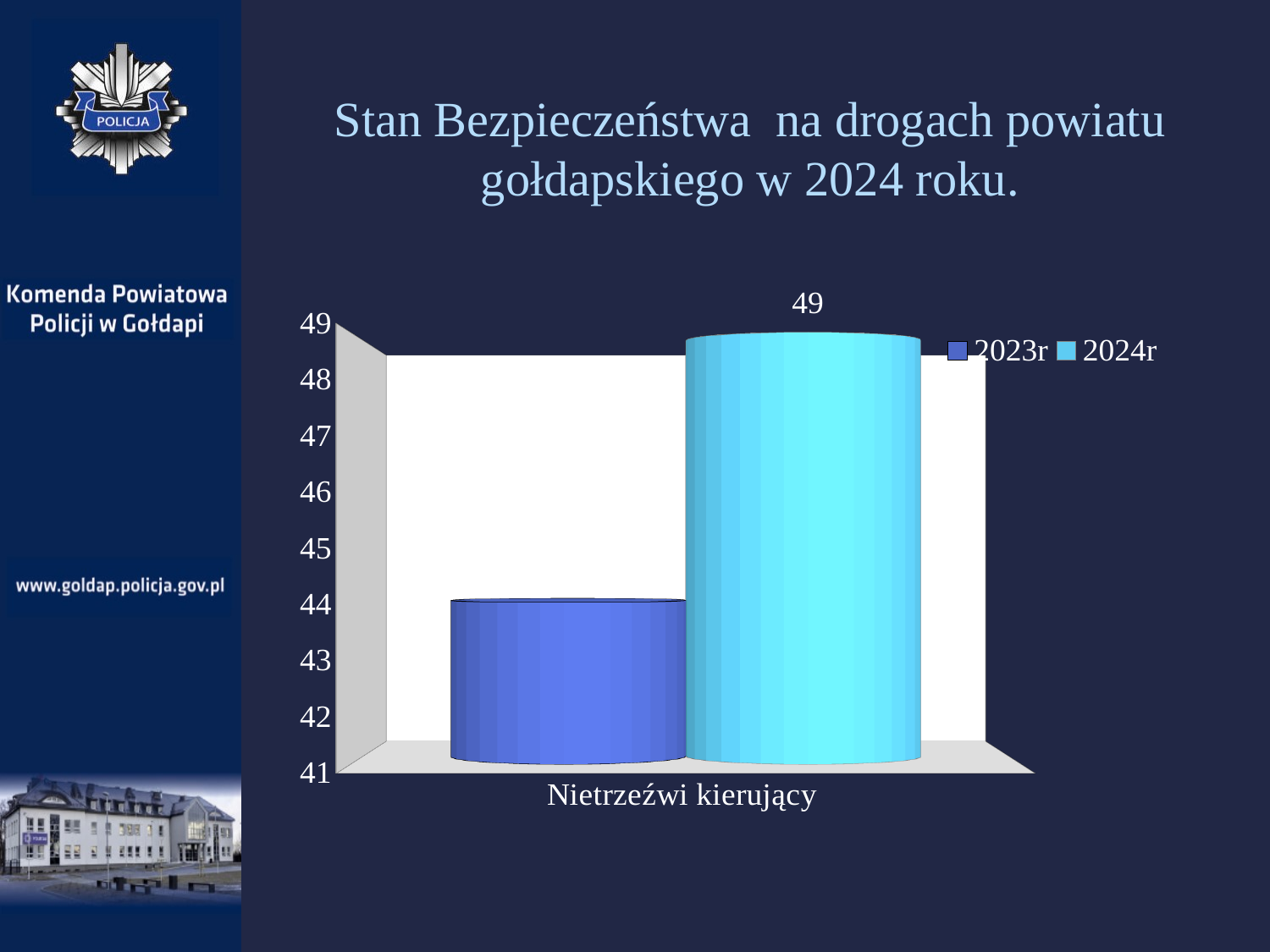
What kind of chart is shown on the slide? bar chart What is the value for the 2024r series in the chart? 49 Is the value for 2023r greater or less than 45? less What are the two series names listed in the chart legend? 2023r and 2024r Which series shows the highest value in the chart? 2024r What is the category label shown on the x axis of the chart? Nietrzeźwi kierujący How many categories are shown on the x axis of the chart? 1 Is the value for 2023r greater or less than 43? greater Which series has the larger value for Nietrzeźwi kierujący, 2023r or 2024r? 2024r Is the value for 2024r greater or less than 48? greater Which series shows the lowest value in the chart? 2023r How many series does the legend list? 2